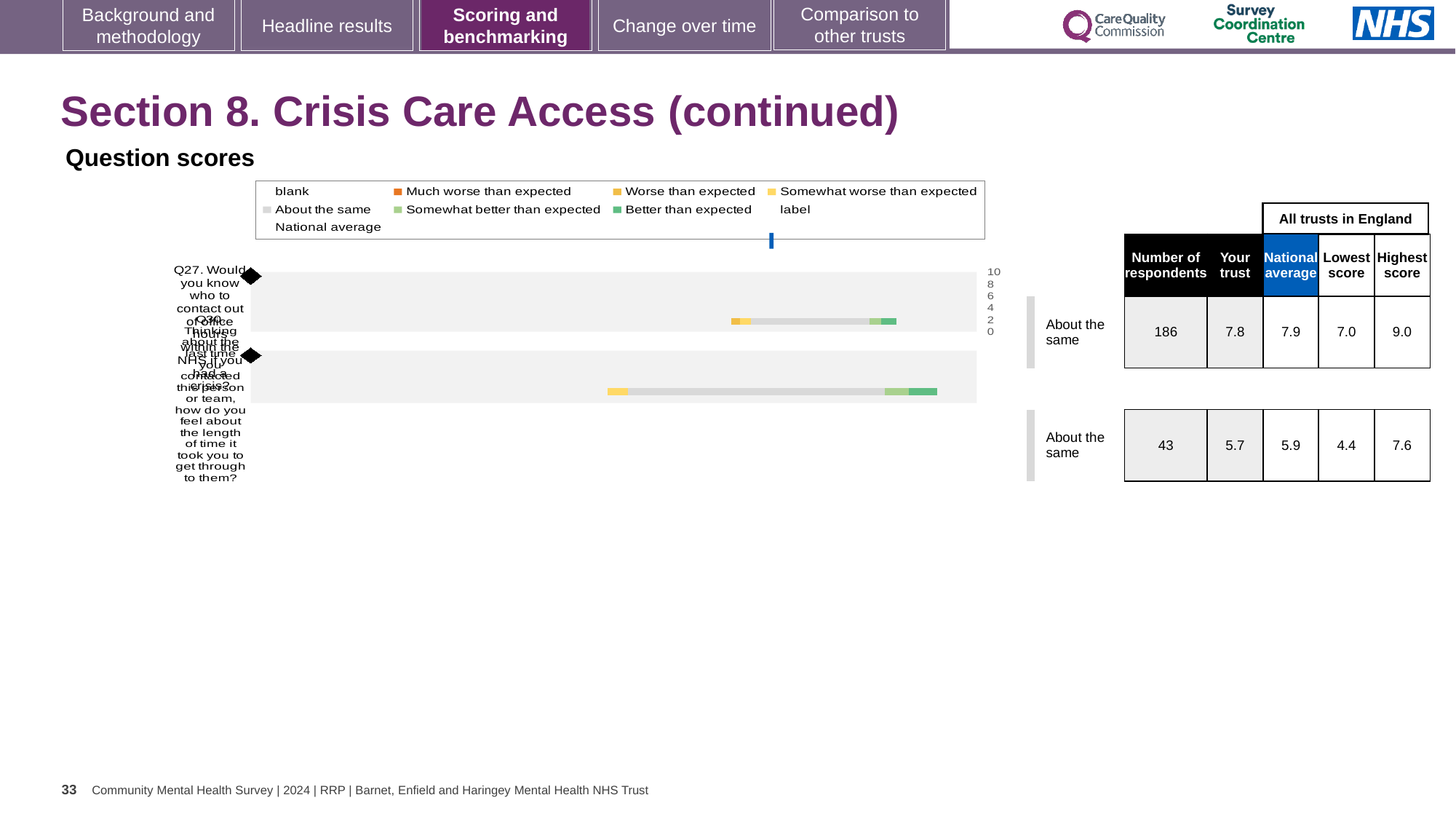
What is the highest score among all trusts in England for Q27? 9.0 How many questions are plotted in the chart? 2 What is the national average score for Q29? 5.9 What is the lowest score among all trusts in England for Q29? 4.4 What is the difference between the highest and lowest scores for Q27? 2.0 How many respondents answered Q27 according to the table? 186 Which question has the higher 'Your trust' score, Q27 or Q29? Q27 What kind of chart is used to show the question scores? Bar chart By how much does the national average exceed the trust's score for Q29? 0.2 What benchmark category is shown for both Q27 and Q29? About the same What is the title of the chart section on this slide? Question scores What is the 'Your trust' score for Q27? 7.8